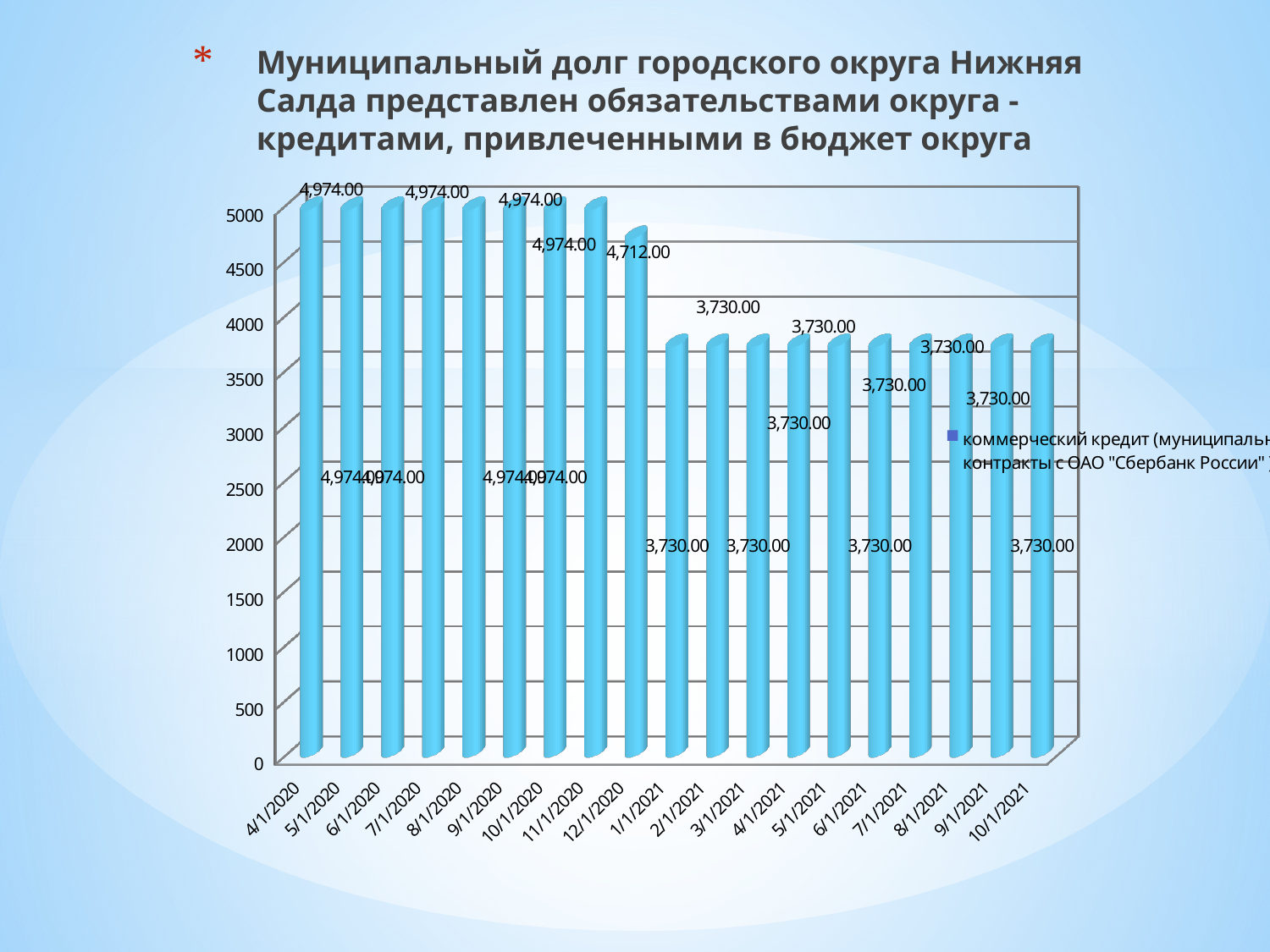
What is the difference between the value for 4/1/2020 and the value for 4/1/2021? 1,244.00 What is the highest value shown in the chart? 4,974.00 What is the lowest value shown in the chart? 3,730.00 What is the value for 12/1/2020? 4,712.00 What is the value for 4/1/2020? 4,974.00 What is the difference between the value for 11/1/2020 and the value for 12/1/2020? 262.00 What is the value for 1/1/2021? 3,730.00 Which is larger, the value for 12/1/2020 or the value for 1/1/2021? 12/1/2020 What kind of chart is shown on the slide? bar chart What is the value for 10/1/2021? 3,730.00 How many bars (dates) are plotted in the chart? 19